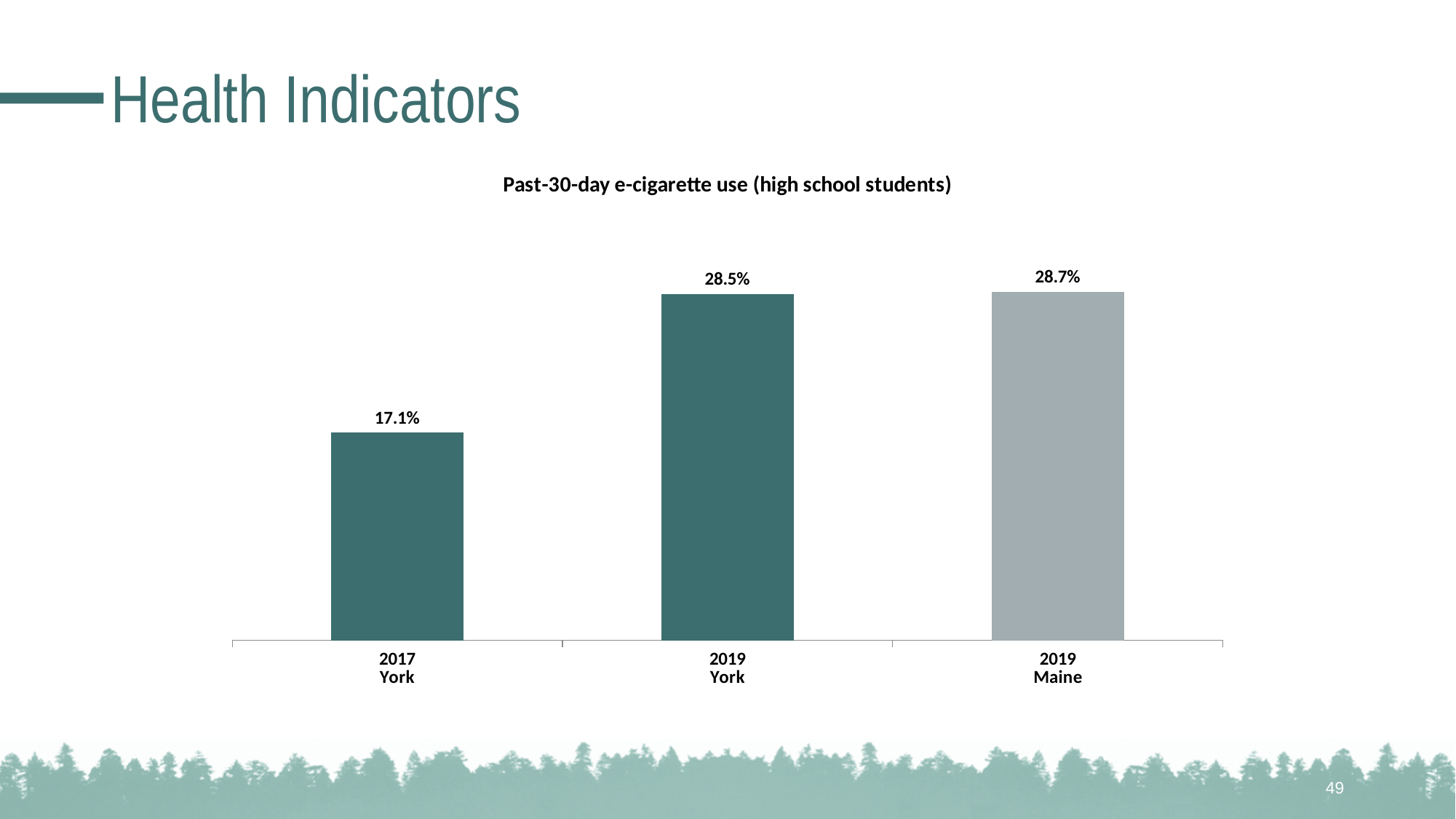
How many bars are shown in the chart? 3 Which is larger, the value for 2017 York or the value for 2019 York? 2019 York What is the difference between the 2019 York and 2017 York values? 11.4% What is the title of the chart? Past-30-day e-cigarette use (high school students) What is the value for 2017 York? 17.1% What is the value for 2019 Maine? 28.7% Which category has the lowest value? 2017 York Did the value for York rise or fall from 2017 to 2019? Rise Which category has the highest value? 2019 Maine What is the difference between the 2019 Maine and 2019 York values? 0.2% What is the value for 2019 York? 28.5% What kind of chart is shown on the slide? Bar chart